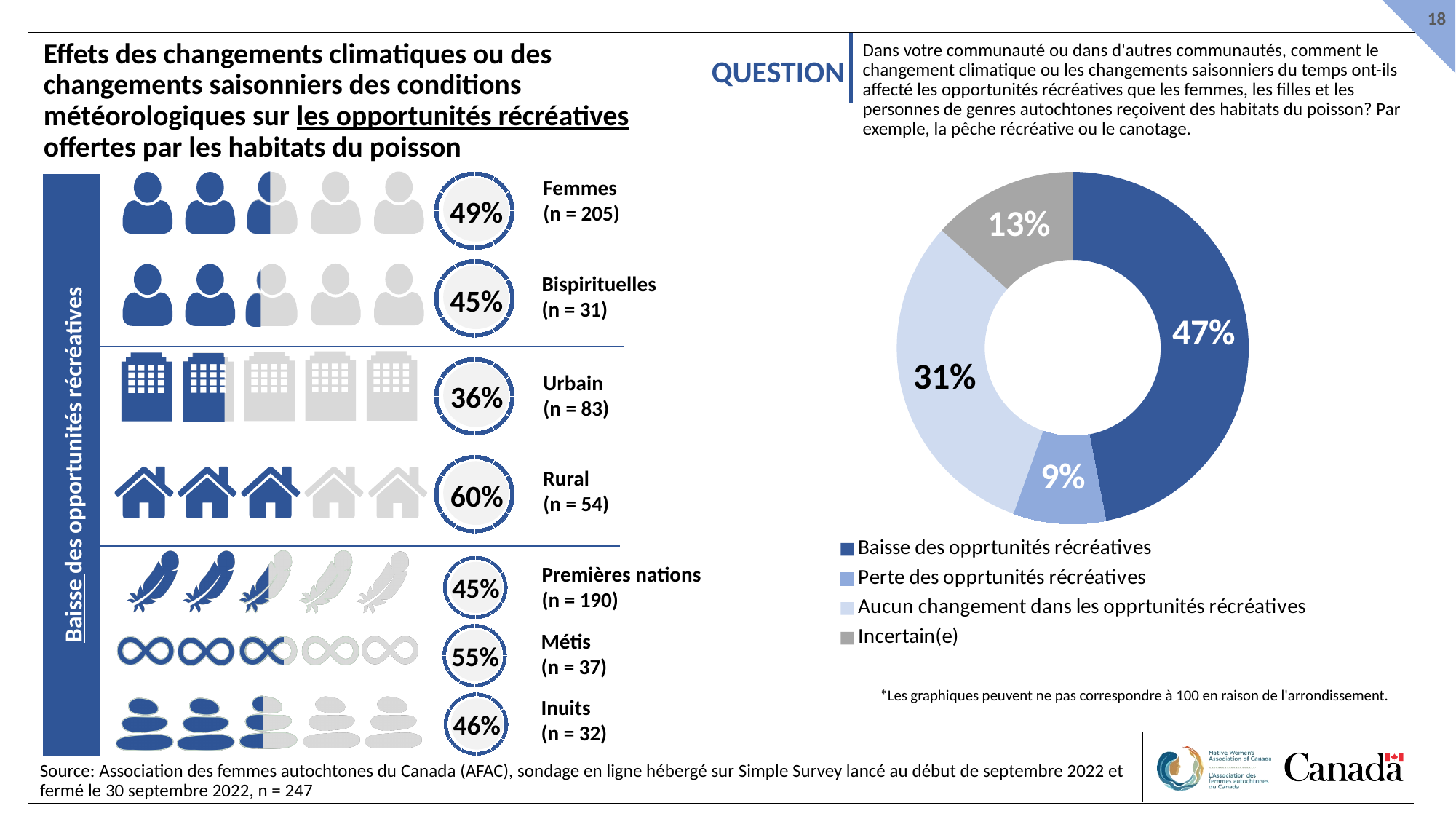
On the pictograph on the left, which is larger: the percentage for 'Métis' or for 'Inuits'? Métis On the pictograph on the left, what percentage is shown for 'Urbain (n = 83)'? 36% On the pictograph on the left, which group has the highest percentage? Rural On the donut chart on the right, what share is labelled for 'Baisse des opprtunités récréatives'? 47% On the donut chart on the right, what is the difference in percentage points between 'Baisse des opprtunités récréatives' and 'Aucun changement dans les opprtunités récréatives'? 16 On the donut chart on the right, which category has the smallest slice? Perte des opprtunités récréatives What kind of chart is shown on the right side of the slide? Donut (pie) chart On the pictograph on the left, what is the difference in percentage points between 'Femmes' and 'Bispirituelles'? 4 On the donut chart on the right, what share is labelled for 'Incertain(e)'? 13% On the donut chart on the right, how many entries does the legend list? 4 On the donut chart on the right, which category has the largest slice? Baisse des opprtunités récréatives On the pictograph on the left, what percentage is shown for 'Rural (n = 54)'? 60%